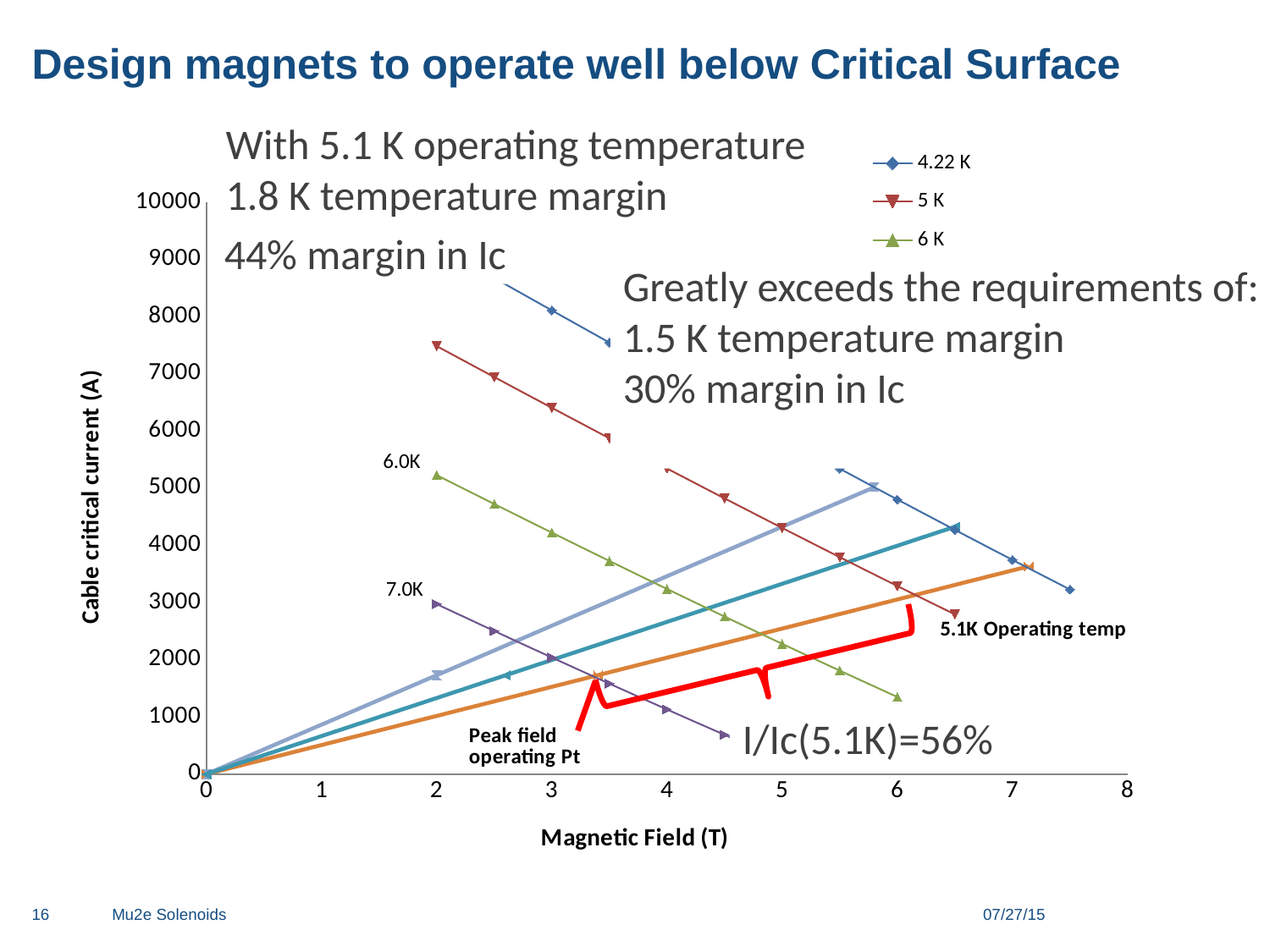
Is the value for the 6 K series at 6 T greater or less than 2000? less At 5 T, which series has the larger cable critical current, 5 K or 6 K? 5 K Is the value for the 5 K series at 2 T greater or less than 7000? greater How many data points are plotted for the 6 K series? 9 Do the values of the 5 K series rise or fall as the magnetic field increases? fall Which legend series has the highest cable critical current at 3 T? 4.22 K Is the value for the 4.22 K series at 7.5 T greater or less than 4000? less What is the title of the x axis of the chart? Magnetic Field (T) How many series does the chart legend list? 3 What is the title of the y axis of the chart? Cable critical current (A) What kind of chart is shown on the slide? line chart